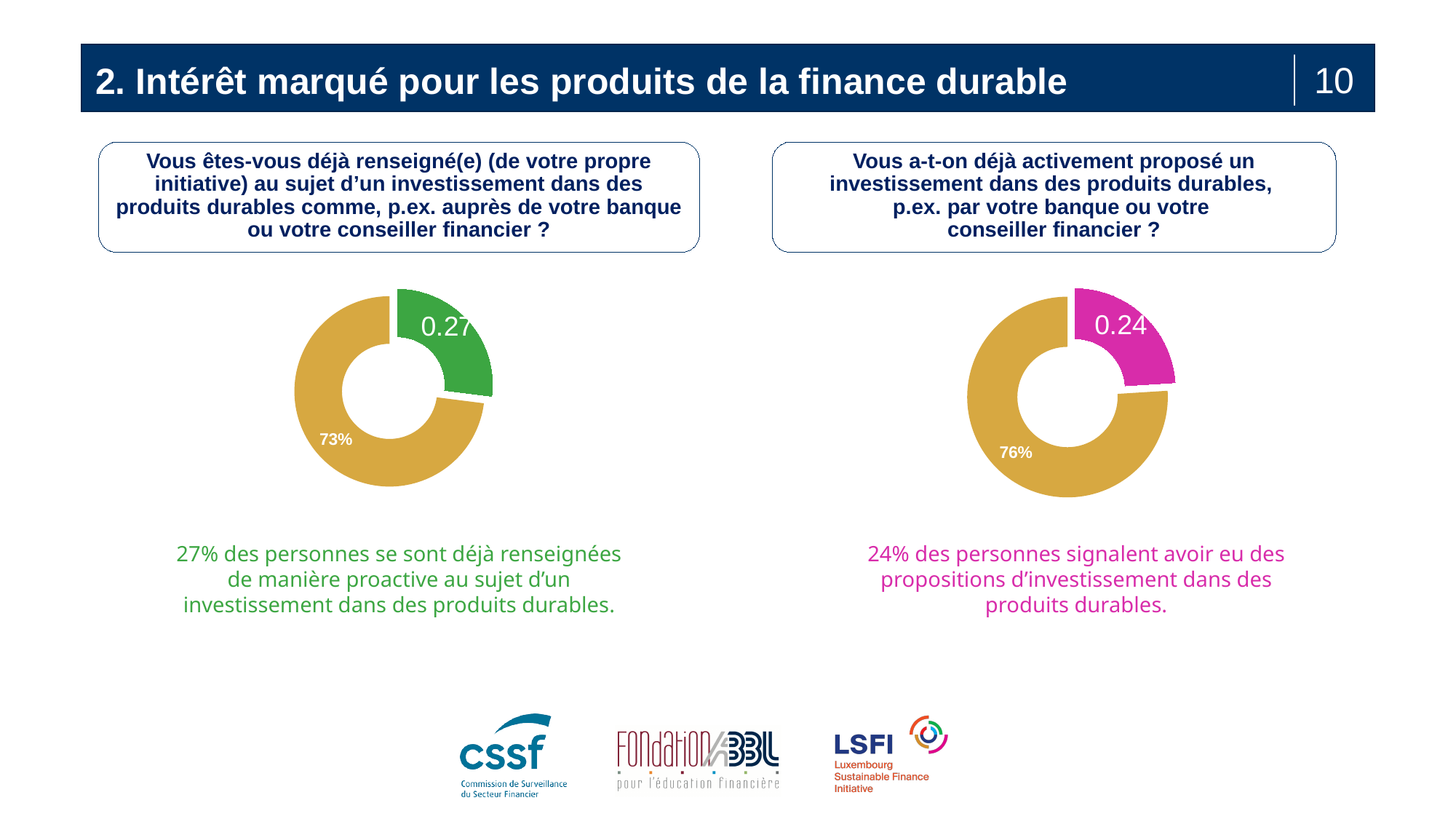
On the left chart, what value is printed on the green slice? 0.27 What kind of chart is shown on the right side of the slide? Doughnut chart What colour is the smaller slice on the right chart? Magenta Which is larger: the green slice on the left chart (0.27) or the magenta slice on the right chart (0.24)? The green slice on the left chart On the right chart, what value is printed on the gold slice? 76% What kind of chart is shown on the left side of the slide? Doughnut chart How many slices does the right chart have? 2 How many slices does the left chart have? 2 On the right chart, which slice is smaller, the magenta one or the gold one? The magenta one On the left chart, what value is printed on the gold slice? 73% On the right chart, what value is printed on the magenta slice? 0.24 On the left chart, which slice is larger, the green one or the gold one? The gold one